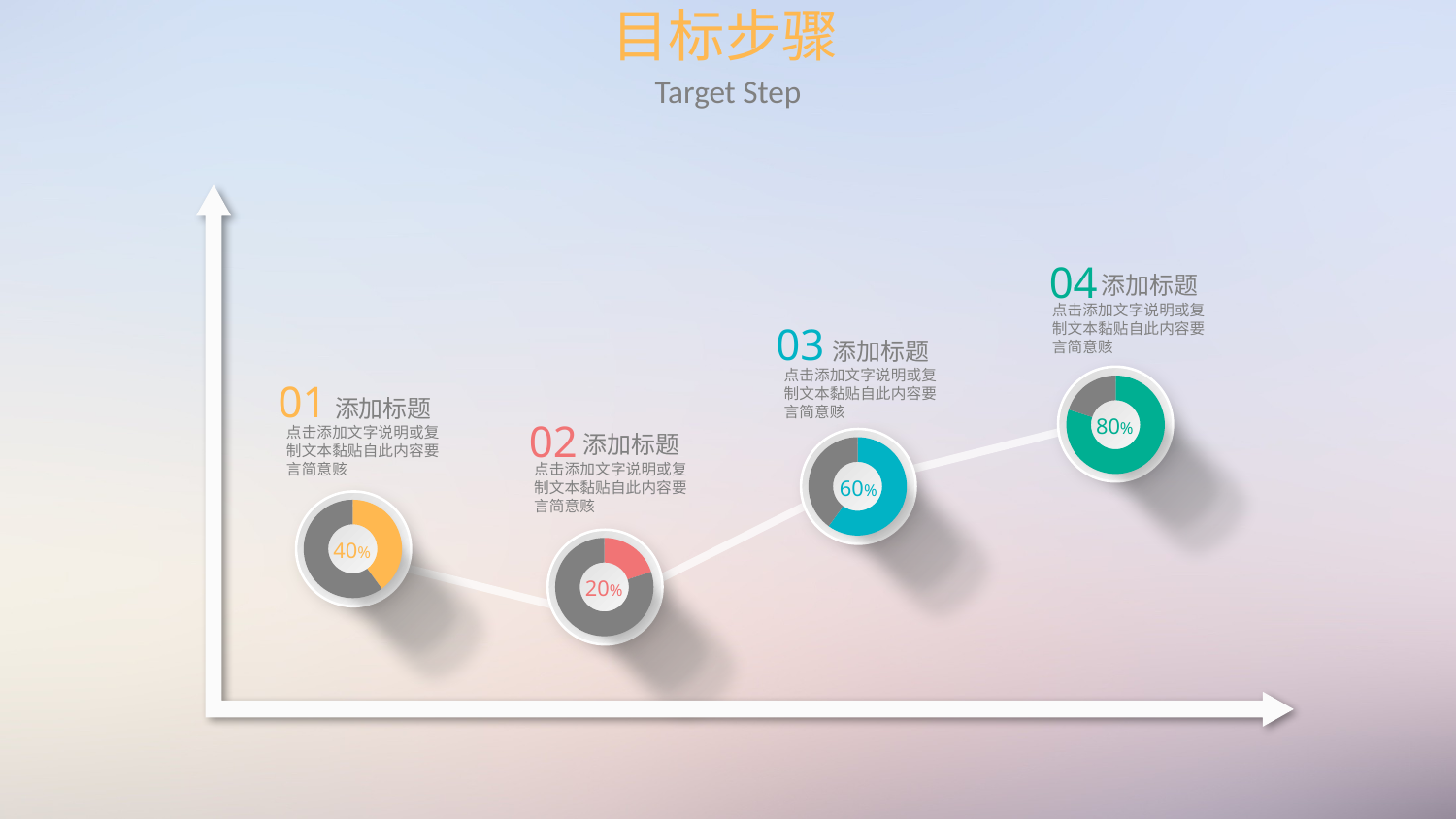
What percentage is shown in the donut chart for step 02? 20% What is the difference between the percentages shown for step 04 and step 01? 40% How many donut charts are placed along the arrow axis on the slide? 4 What percentage is shown in the donut chart for step 04? 80% Do the percentages rise or fall from step 02 to step 04? rise What kind of chart is used to show each step's percentage? donut (pie) chart What colour is the filled portion of the donut chart for step 03? blue What percentage is shown in the donut chart for step 03? 60% Which step has the lowest percentage in its donut chart? 02 What percentage is shown in the donut chart for step 01? 40% Which step has the highest percentage in its donut chart? 04 Which is larger, the percentage for step 01 or the percentage for step 02? step 01